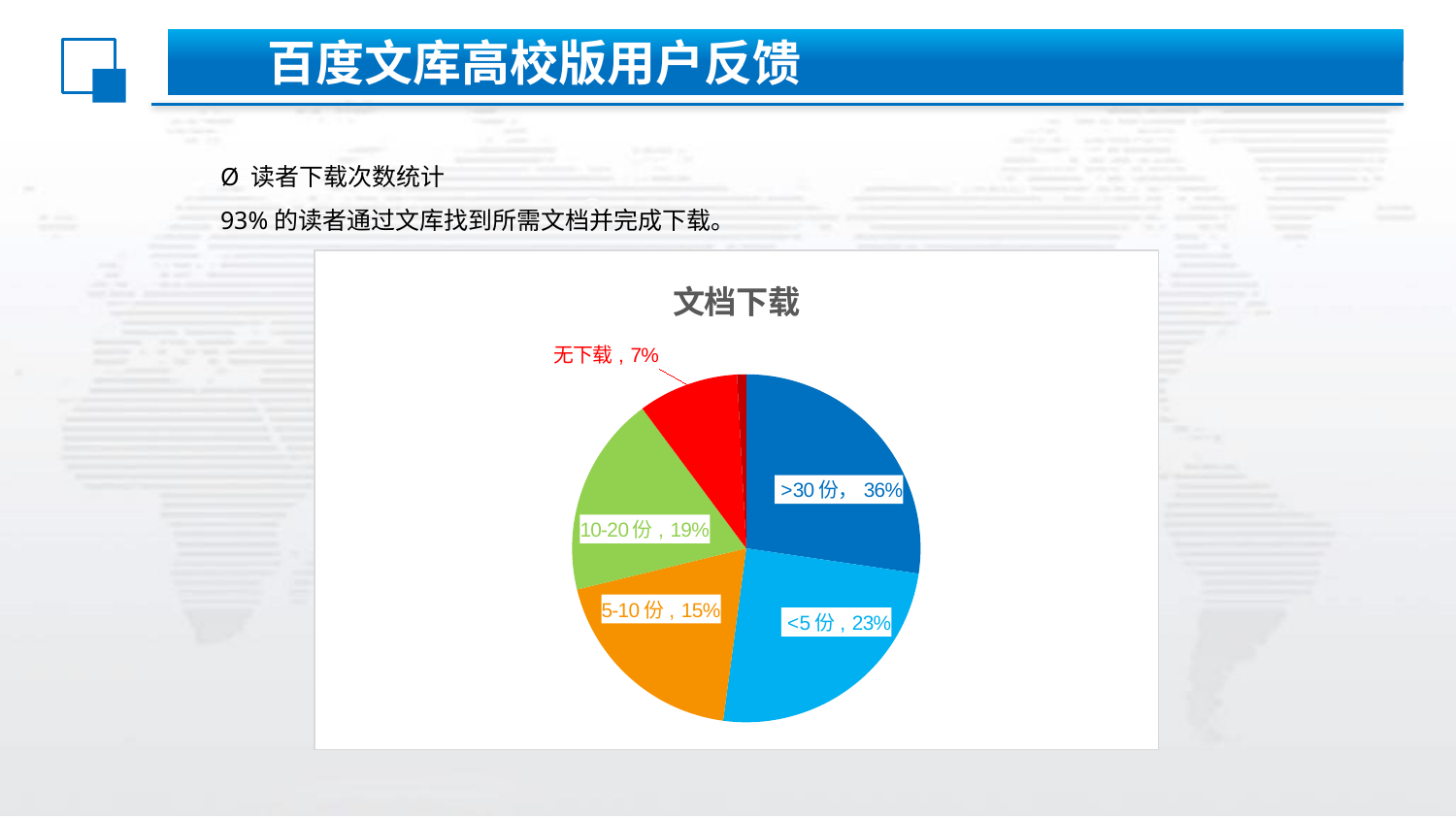
Which labeled slice is the smallest? 无下载 Which labeled slice is the largest? >30份 What share of the pie does the >30份 slice represent? 36% What is the value shown for 10-20份? 19% What is the value shown for <5份? 23% What is the value shown for 无下载? 7% Which is larger, the 10-20份 slice or the 5-10份 slice? 10-20份 What is the value shown for 5-10份? 15% What is the difference between the >30份 slice and the <5份 slice? 13% What colour is the 无下载 slice? red What is the title of the chart? 文档下载 What kind of chart is shown on the slide? pie chart